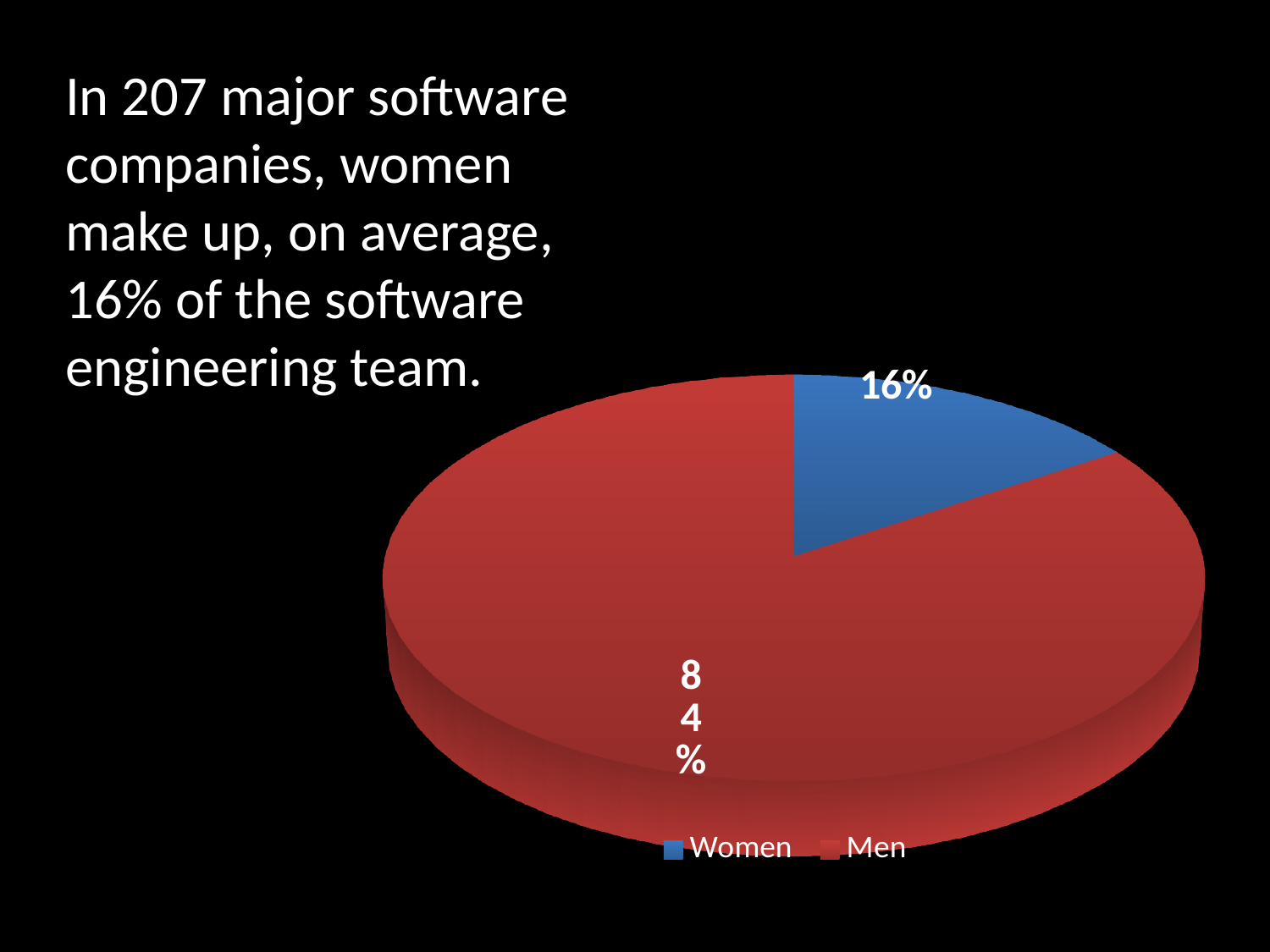
What percentage of the pie chart is labelled for Women? 16% What share of the pie does the Women slice represent? 16% Which slice is larger, Women or Men? Men What is the difference in percentage points between the Men slice and the Women slice? 68 Which category has the largest slice of the pie chart? Men How many entries does the legend list? 2 Which category has the smallest slice of the pie chart? Women What colour is the Men slice in the pie chart? red What kind of chart is shown on the slide? pie chart What colour is the Women slice in the pie chart? blue What percentage of the pie chart is labelled for Men? 84% How many categories does the pie chart show? 2